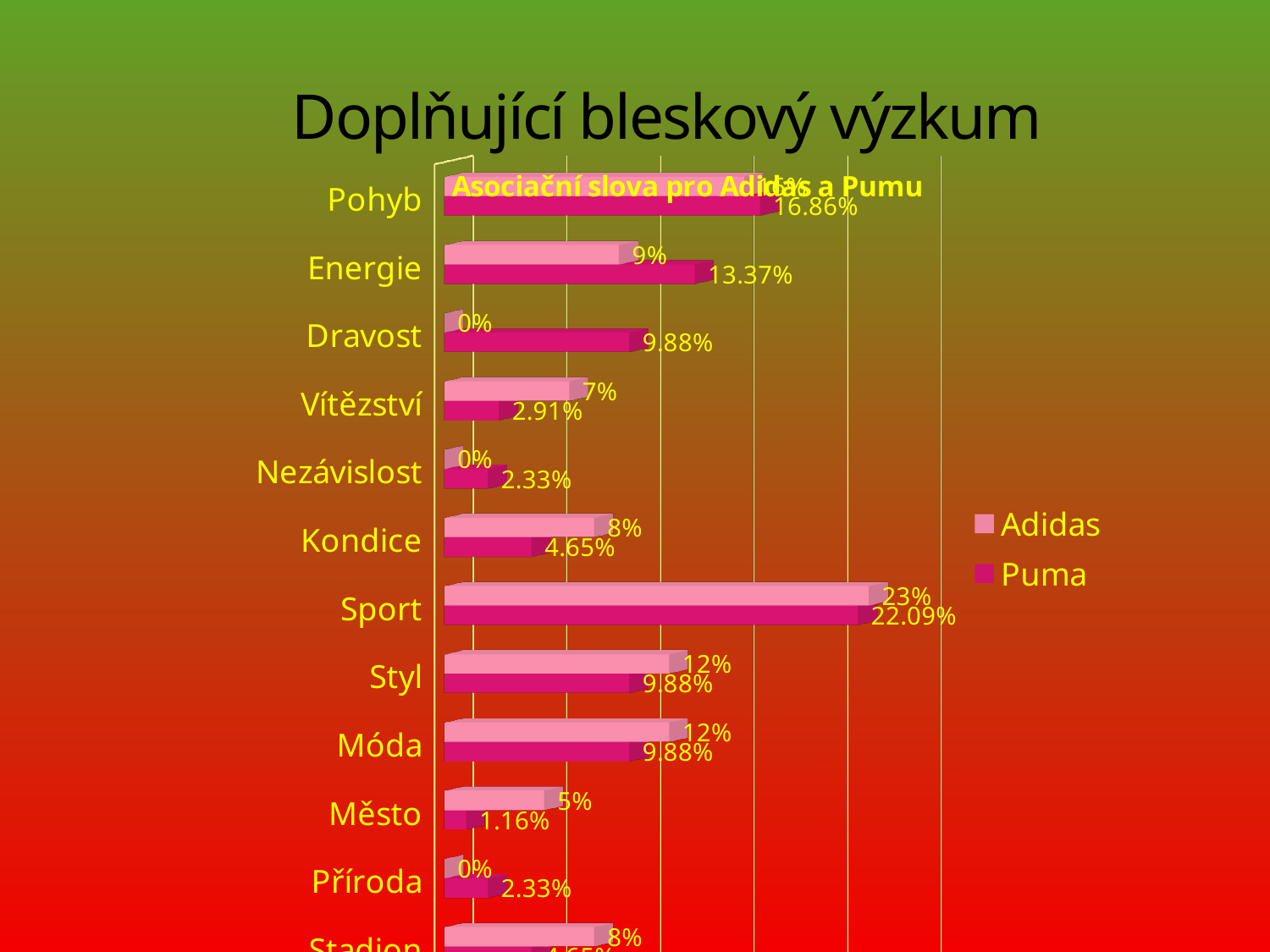
What is the Adidas value for Sport? 23% How many series does the legend list? 2 What is the difference between the Puma and Adidas values for Energie? 4.37% What is the Adidas value for Dravost? 0% What is the Puma value for Město? 1.16% Which category has the highest Puma value? Sport Which category has the highest Adidas value? Sport For Vítězství, which series has the larger value, Adidas or Puma? Adidas What is the Puma value for Nezávislost? 2.33% What kind of chart is shown on the slide? Bar chart What is the title of the chart? Asociační slova pro Adidas a Pumu What is the Puma value for Energie? 13.37%